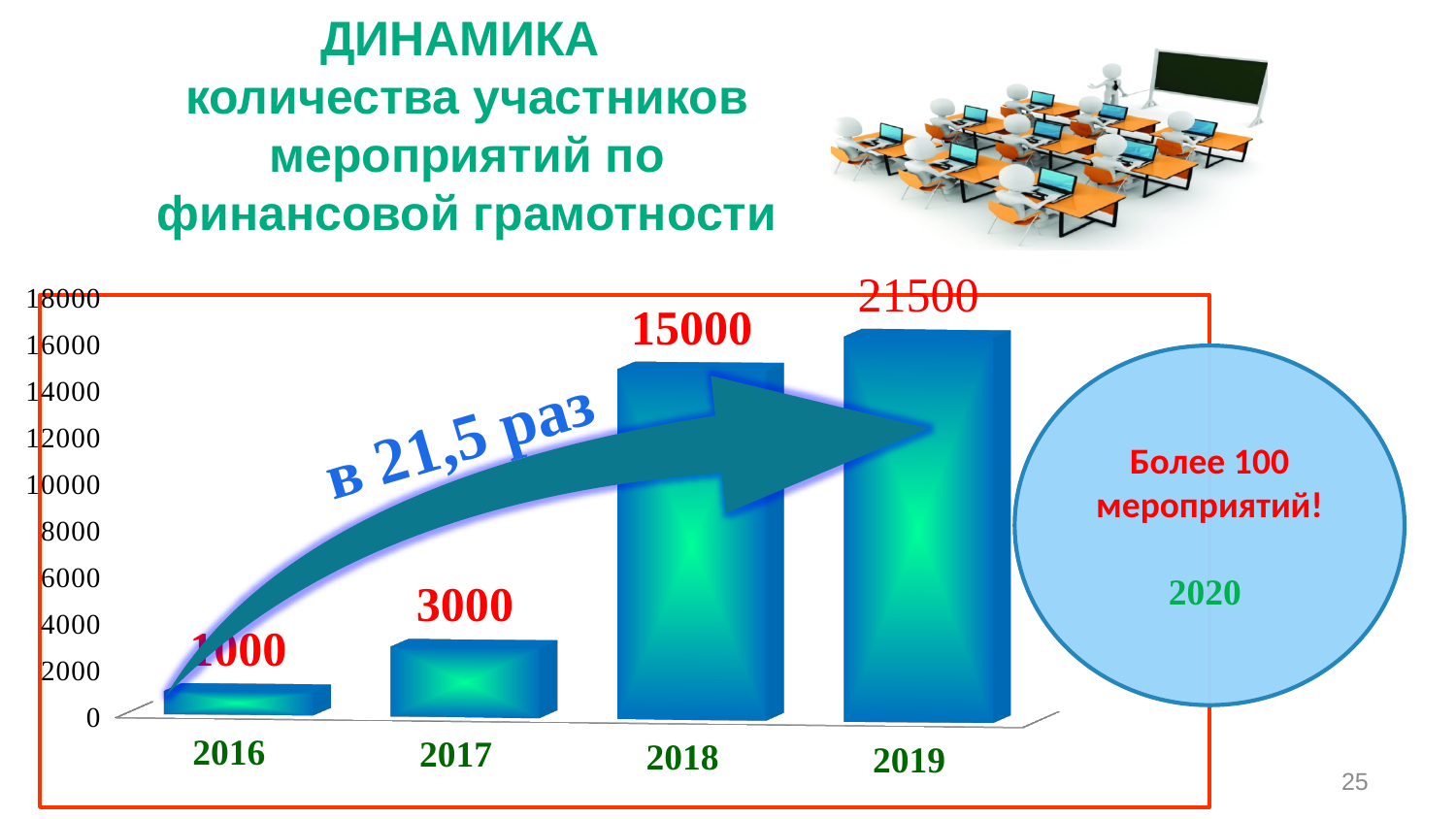
Which year has the lowest number of participants? 2016 What is the difference between the values for 2019 and 2018? 6500 What kind of chart is shown on the slide? Bar chart What value is labelled on the bar for 2017? 3000 Which year has the highest number of participants? 2019 What value is labelled on the bar for 2019? 21500 What is the number of participants shown for 2018? 15000 How many years are shown on the x axis of the chart? 4 Which is larger, the value for 2017 or the value for 2018? 2018 Do the values rise or fall from 2016 to 2019? Rise What value is labelled on the bar for 2016? 1000 What is the difference between the values for 2018 and 2017? 12000